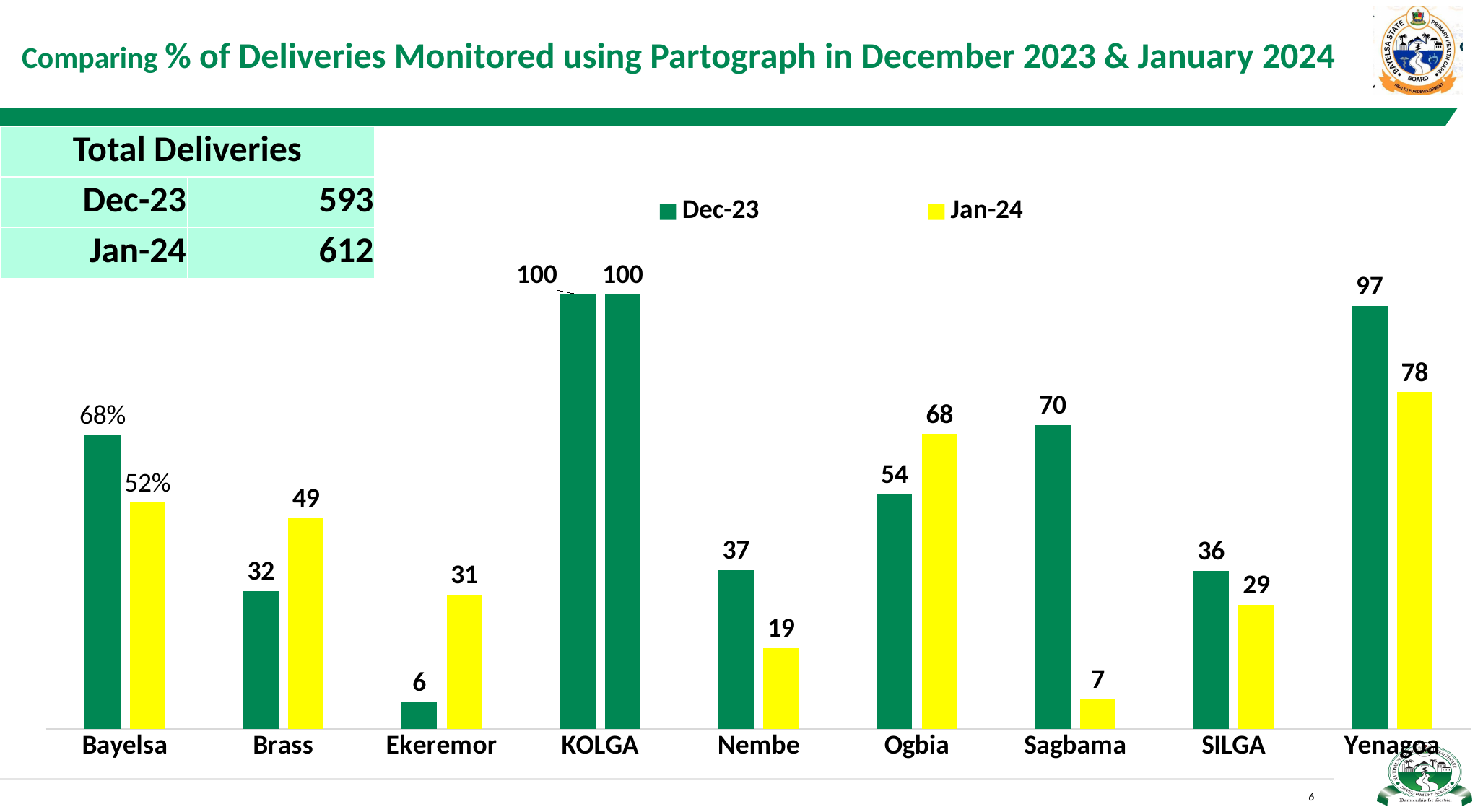
Which category has the lowest Dec-23 value? Ekeremor How many series does the legend list? 2 How many categories are shown on the x axis? 9 What is the difference between the Dec-23 and Jan-24 values for Nembe? 18 What is the Jan-24 value for Ekeremor? 31 What is the difference between the Jan-24 and Dec-23 values for Ogbia? 14 What is the Jan-24 value for Bayelsa? 52% Which category has the lowest Jan-24 value? Sagbama Which colour represents the Jan-24 series? Yellow Which is larger for Brass, the Dec-23 value or the Jan-24 value? Jan-24 What kind of chart is shown on the slide? Bar chart What is the Dec-23 value for Sagbama? 70